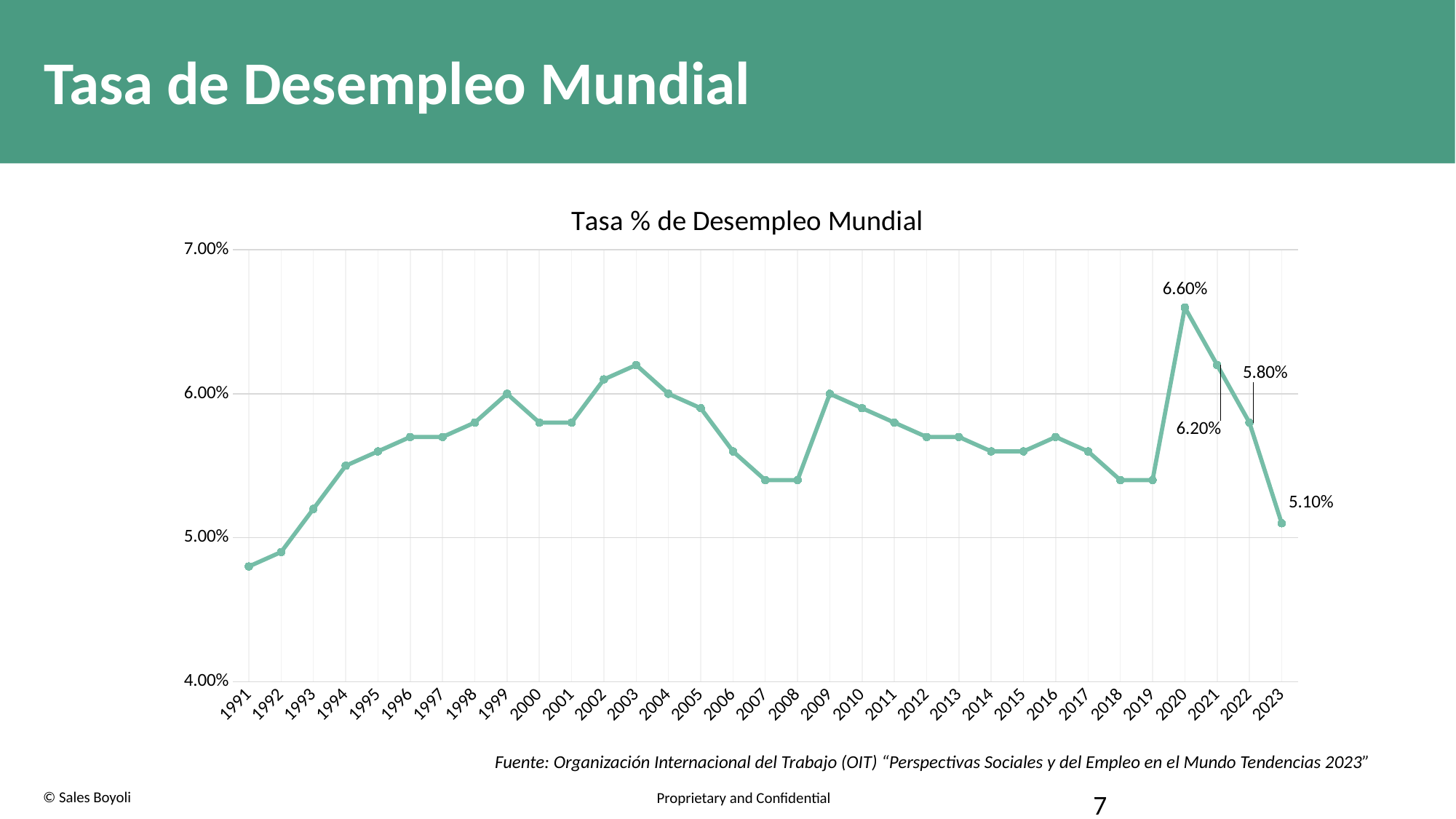
What is the value for 2022? 5.80% How many years are plotted on the x axis? 33 What is the value for 2021? 6.20% What is the difference between the values for 2020 and 2023? 1.50% Which year has the lowest unemployment rate? 1991 What is the value for 2020? 6.60% Which year has the highest unemployment rate? 2020 Is the value for 1991 greater or less than 5.00%? less Is the value for 2003 greater or less than 6.00%? greater What kind of chart is shown? line chart Which is larger, the value for 2020 or the value for 2022? 2020 What is the value for 2023? 5.10%